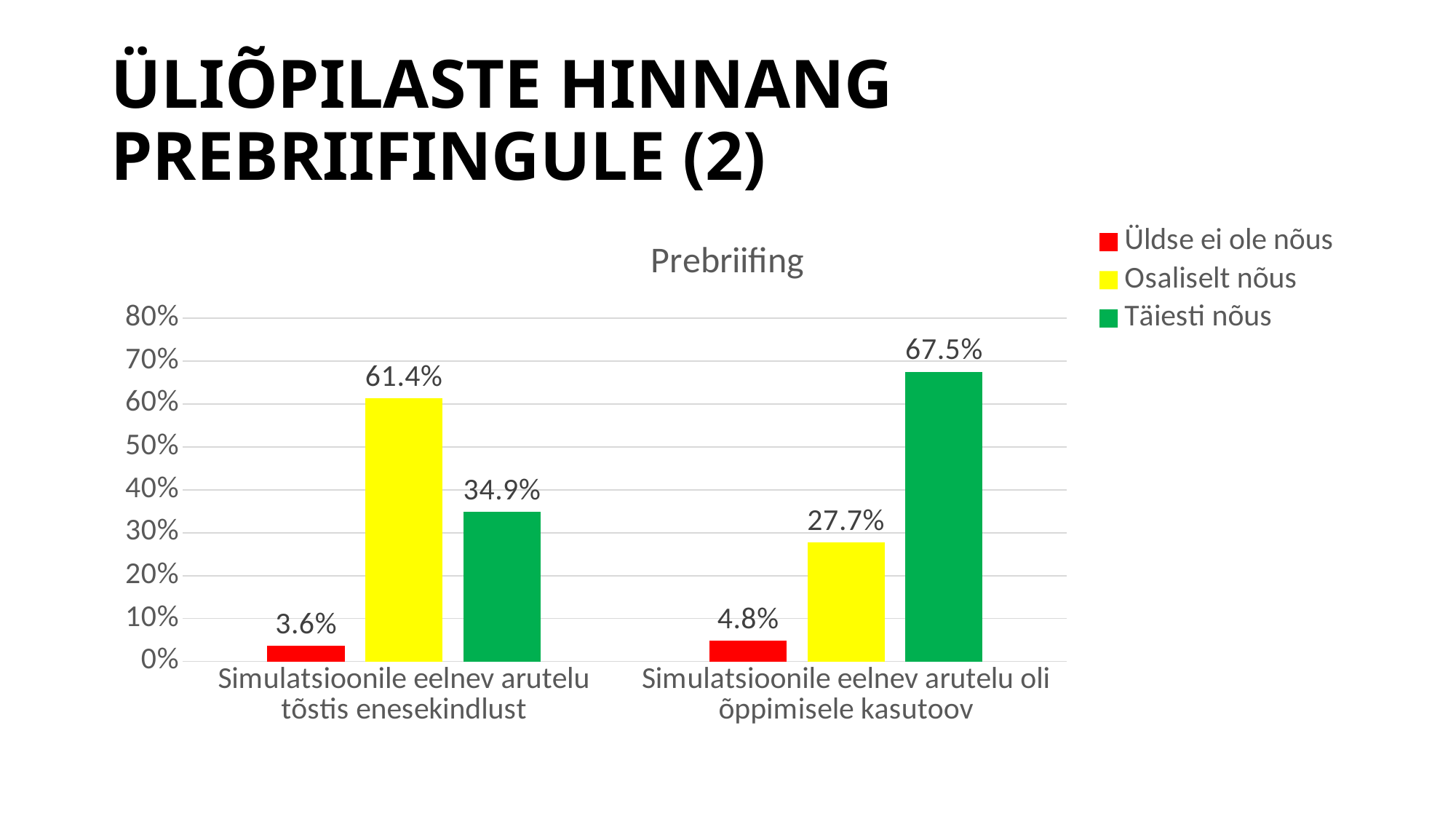
What is the difference between the "Täiesti nõus" values for the two categories? 32.6% What is the title of the chart? Prebriifing Which series has the lowest value in the category "Simulatsioonile eelnev arutelu oli õppimisele kasutoov"? Üldse ei ole nõus Which is larger: "Täiesti nõus" for "Simulatsioonile eelnev arutelu tõstis enesekindlust" or "Osaliselt nõus" for "Simulatsioonile eelnev arutelu oli õppimisele kasutoov"? Täiesti nõus for "Simulatsioonile eelnev arutelu tõstis enesekindlust" What is the value for "Üldse ei ole nõus" in the category "Simulatsioonile eelnev arutelu tõstis enesekindlust"? 3.6% Which series has the highest value in the category "Simulatsioonile eelnev arutelu tõstis enesekindlust"? Osaliselt nõus How many series does the legend list? 3 What is the value for "Osaliselt nõus" in the category "Simulatsioonile eelnev arutelu oli õppimisele kasutoov"? 27.7% What is the value for "Täiesti nõus" in the category "Simulatsioonile eelnev arutelu oli õppimisele kasutoov"? 67.5% How many categories are shown on the x axis? 2 What is the value for "Osaliselt nõus" in the category "Simulatsioonile eelnev arutelu tõstis enesekindlust"? 61.4% What kind of chart is shown on the slide? Bar chart